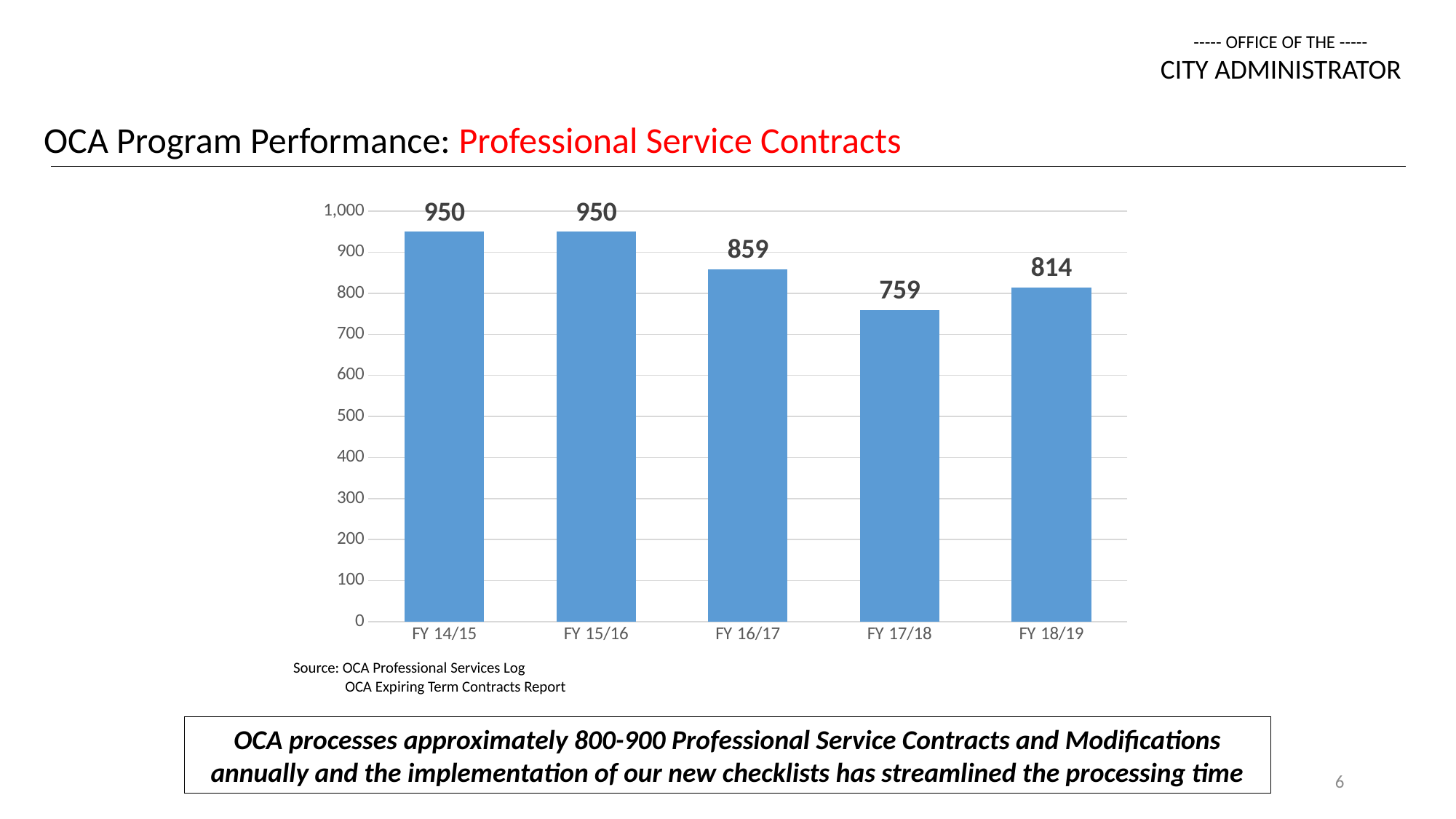
What is the difference between the values for FY 15/16 and FY 18/19? 136 What is the difference between the values for FY 16/17 and FY 17/18? 100 What is the value for FY 14/15? 950 Which fiscal year has the lowest value? FY 17/18 Is the value for FY 17/18 greater or less than 800? less What is the value for FY 17/18? 759 What kind of chart is shown on the slide? bar chart Which is larger, the value for FY 16/17 or the value for FY 18/19? FY 16/17 What is the source listed below the chart? OCA Professional Services Log, OCA Expiring Term Contracts Report What is the value for FY 18/19? 814 How many fiscal years are shown on the chart? 5 What is the value for FY 16/17? 859